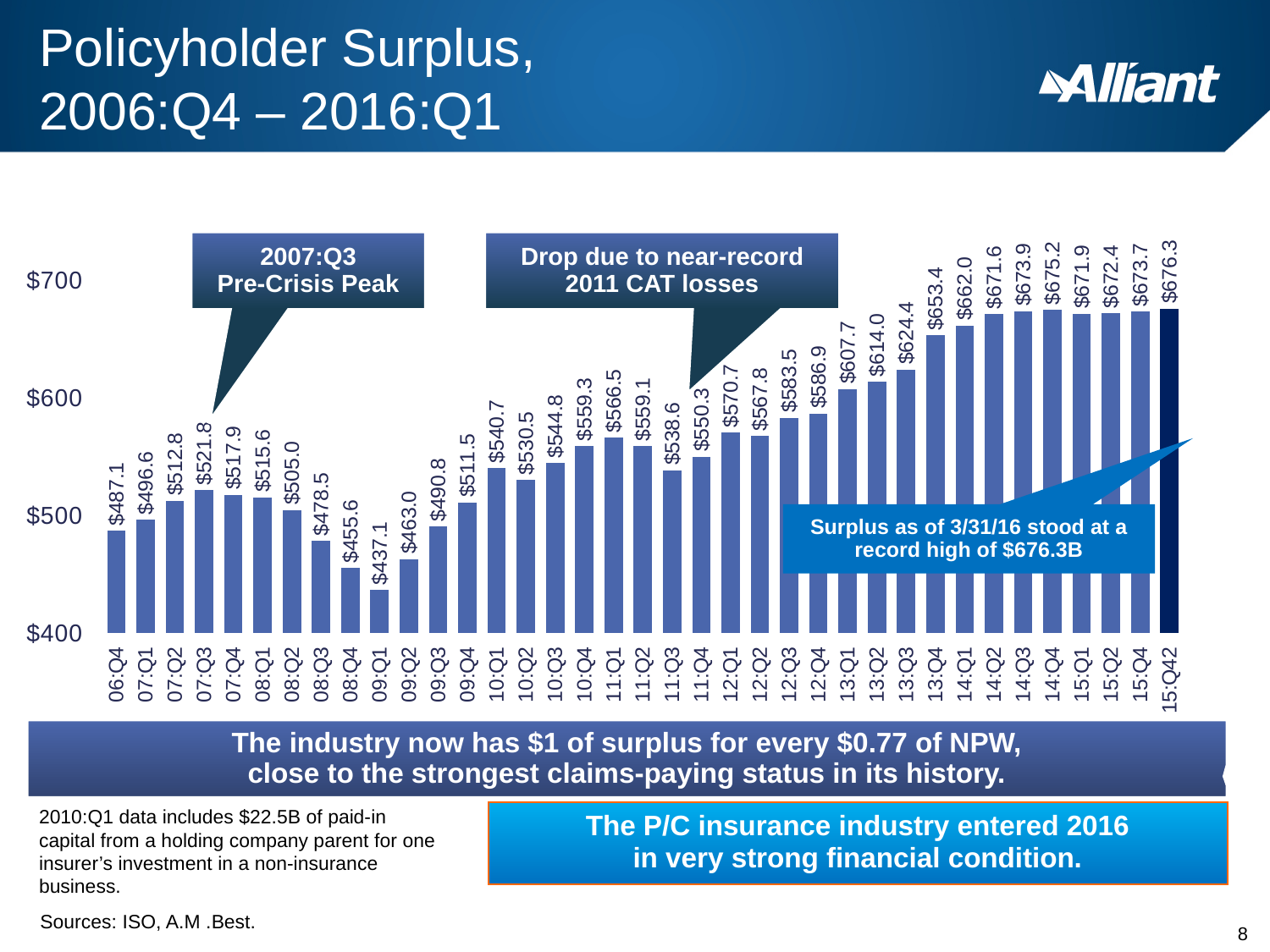
What is the difference between the values for 07:Q3 and 09:Q1? $84.7 What is the value shown for 13:Q4? $653.4 What is the highest value plotted on the chart? $676.3 Which quarter has the lowest policyholder surplus? 09:Q1 What is the value shown for 09:Q1? $437.1 How many bars are plotted on the chart? 37 Do the values generally rise or fall from 13:Q1 to 14:Q4? rise What is the policyholder surplus value shown for 07:Q3? $521.8 Which is larger, the value for 11:Q1 or the value for 11:Q2? 11:Q1 According to the callout on the chart, what caused the drop in 2011? Near-record 2011 CAT losses Is the value for 12:Q4 greater or less than $600? less What kind of chart is shown on the slide? bar chart